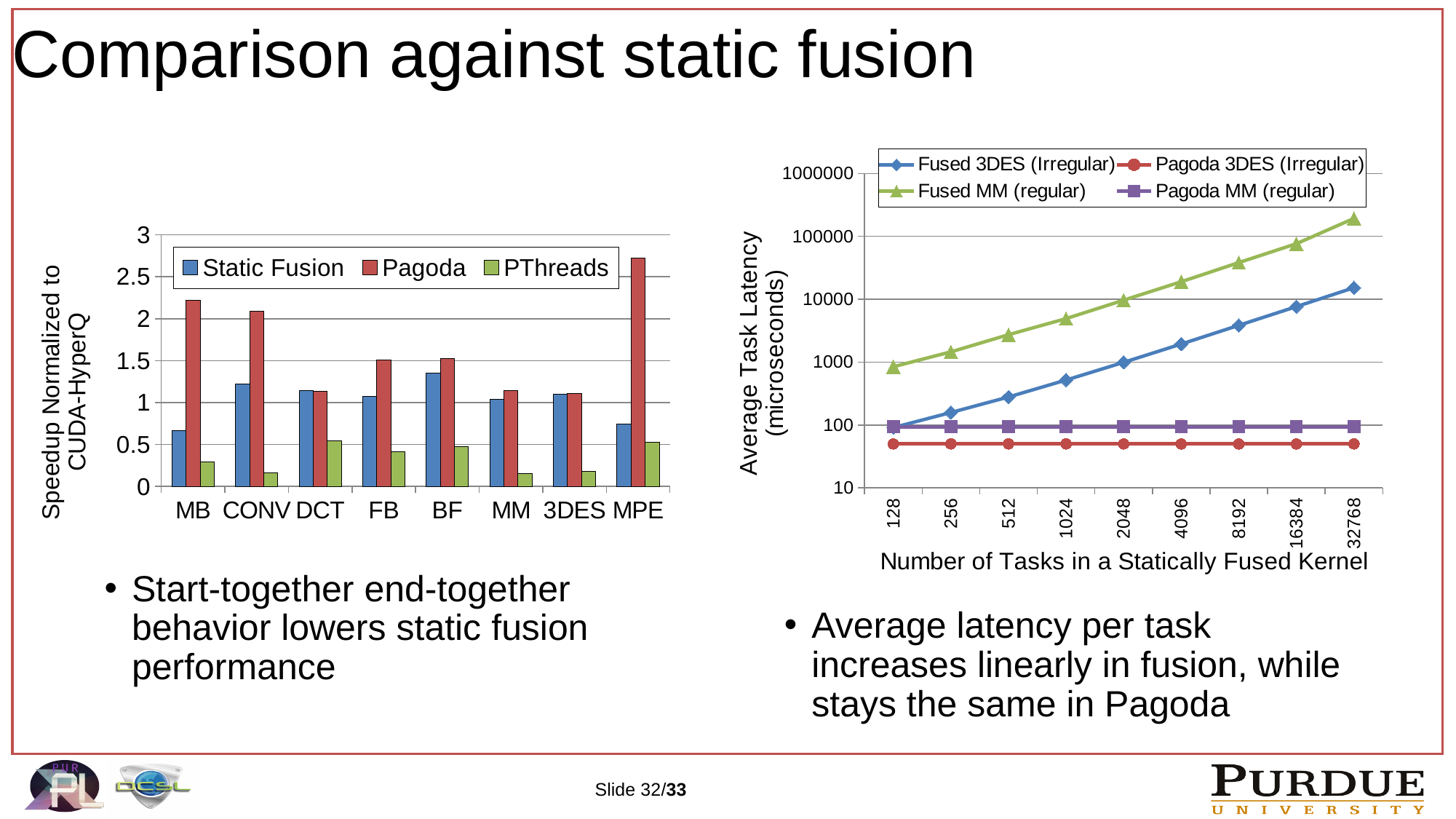
On the left chart, which category has the highest Pagoda speedup? MPE On the right chart, does the Fused MM (regular) latency rise or fall as the number of tasks increases? rise On the left chart, how many series does the legend list? 3 On the left chart, what is the y-axis label? Speedup Normalized to CUDA-HyperQ On the left chart, is the Static Fusion value for MB greater or less than 1? less On the right chart, how many task-count points are shown on the x axis? 9 On the right chart, which series has the highest latency at 32768 tasks? Fused MM (regular) What kind of chart is the right chart? line chart On the left chart, how many benchmark categories are shown on the x axis? 8 On the right chart, how many series does the legend list? 4 On the left chart, which is larger for MB: Static Fusion or Pagoda? Pagoda On the left chart, is the Pagoda value for MB greater or less than 2? greater